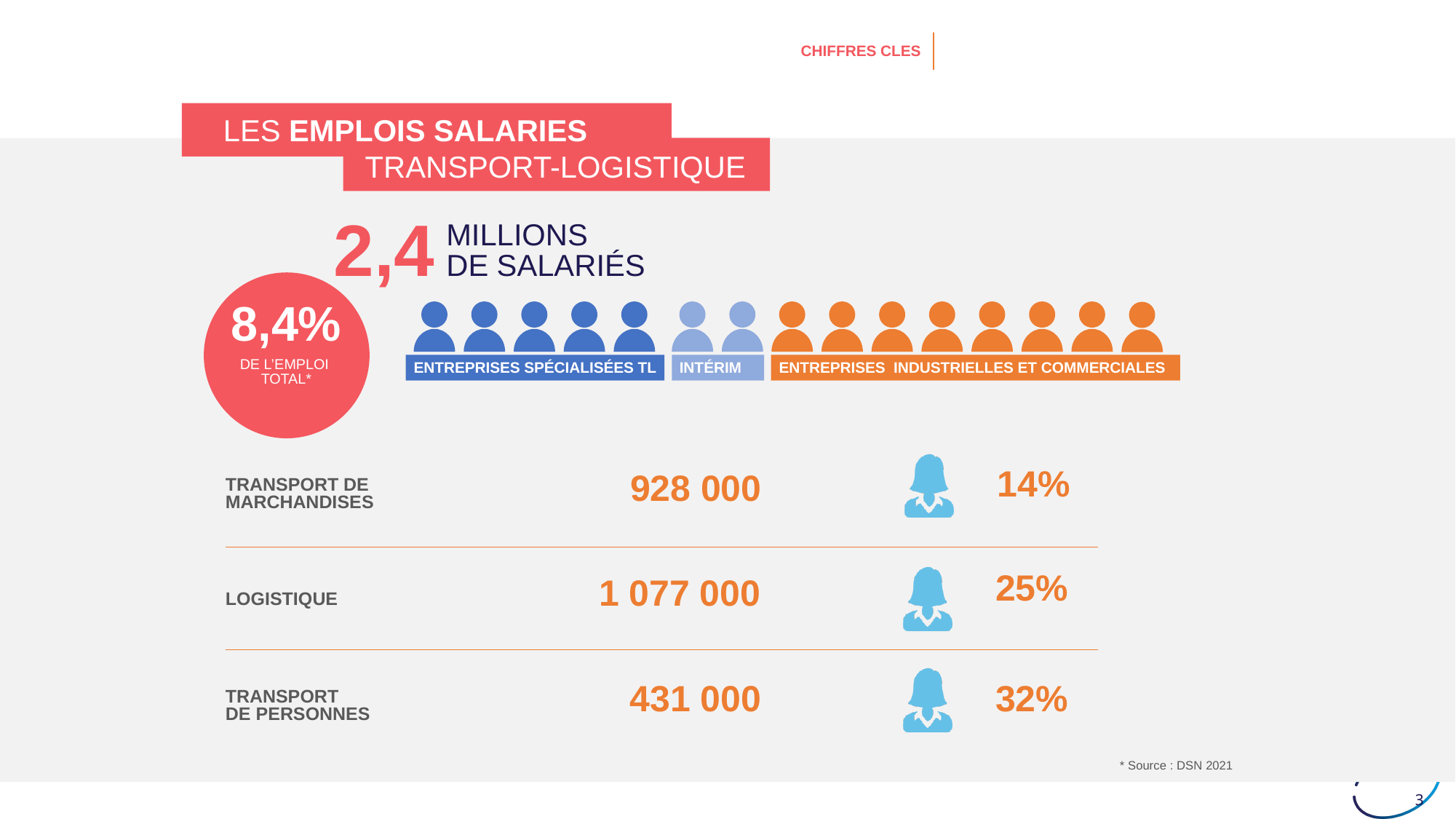
Which of the three sectors listed has the highest number of salaried employees? Logistique Which has more salaried employees, Transport de marchandises or Transport de personnes? Transport de marchandises How many categories are labelled in the pictogram of person icons? 3 How many salaried employees are shown for Logistique? 1 077 000 What is the difference in salaried employees between Logistique and Transport de marchandises? 149 000 What share of total employment do the transport-logistique salaried jobs represent, according to the red circle? 8,4% What kind of chart is the row of person icons? Pictogram Which of the three sectors listed has the lowest number of salaried employees? Transport de personnes How many salaried employees are shown for Transport de marchandises? 928 000 What percentage is shown next to the female icon for Transport de personnes? 32% How many salaried employees are shown for Transport de personnes? 431 000 In the pictogram of person icons, how many icons represent Entreprises industrielles et commerciales? 8